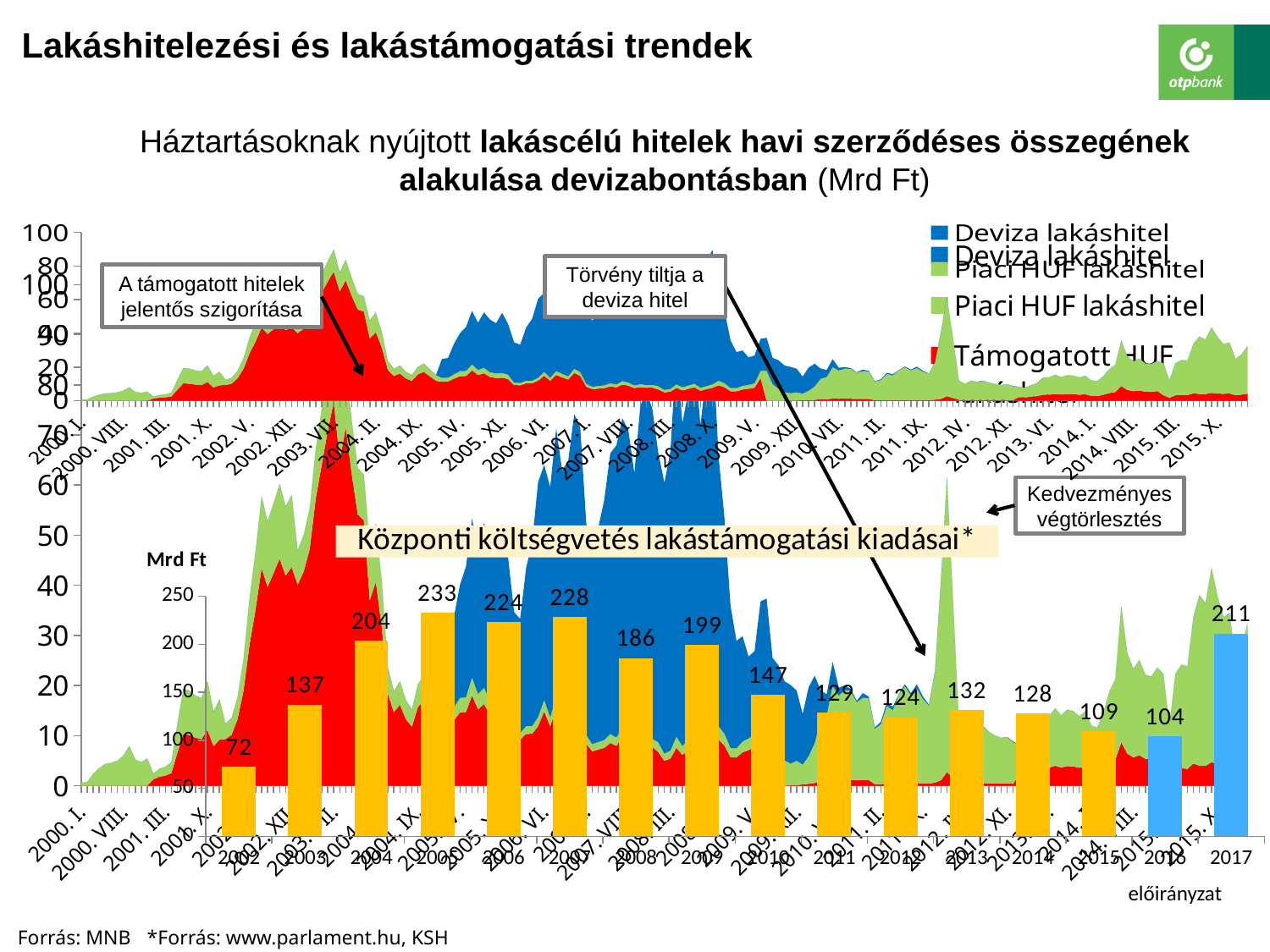
On the bar chart 'Központi költségvetés lakástámogatási kiadásai', which year has the highest value? 2005 On the bar chart 'Központi költségvetés lakástámogatási kiadásai', how many years are shown? 16 On the bar chart 'Központi költségvetés lakástámogatási kiadásai', what is the value for 2005? 233 On the bar chart 'Központi költségvetés lakástámogatási kiadásai', what is the value for 2010? 147 On the bar chart 'Központi költségvetés lakástámogatási kiadásai', what is the difference between the values for 2004 and 2003? 67 On the bar chart 'Központi költségvetés lakástámogatási kiadásai', which is larger, the value for 2008 or the value for 2009? 2009 On the bar chart 'Központi költségvetés lakástámogatási kiadásai', what is the value for 2017? 211 On the bar chart 'Központi költségvetés lakástámogatási kiadásai', what is the value for 2002? 72 On the bar chart 'Központi költségvetés lakástámogatási kiadásai', what is the difference between the values for 2017 and 2016? 107 On the area chart of housing loans by currency, what colour represents 'Deviza lakáshitel' in the legend? blue What kind of chart is 'Központi költségvetés lakástámogatási kiadásai'? bar chart On the bar chart 'Központi költségvetés lakástámogatási kiadásai', which year has the lowest value? 2002